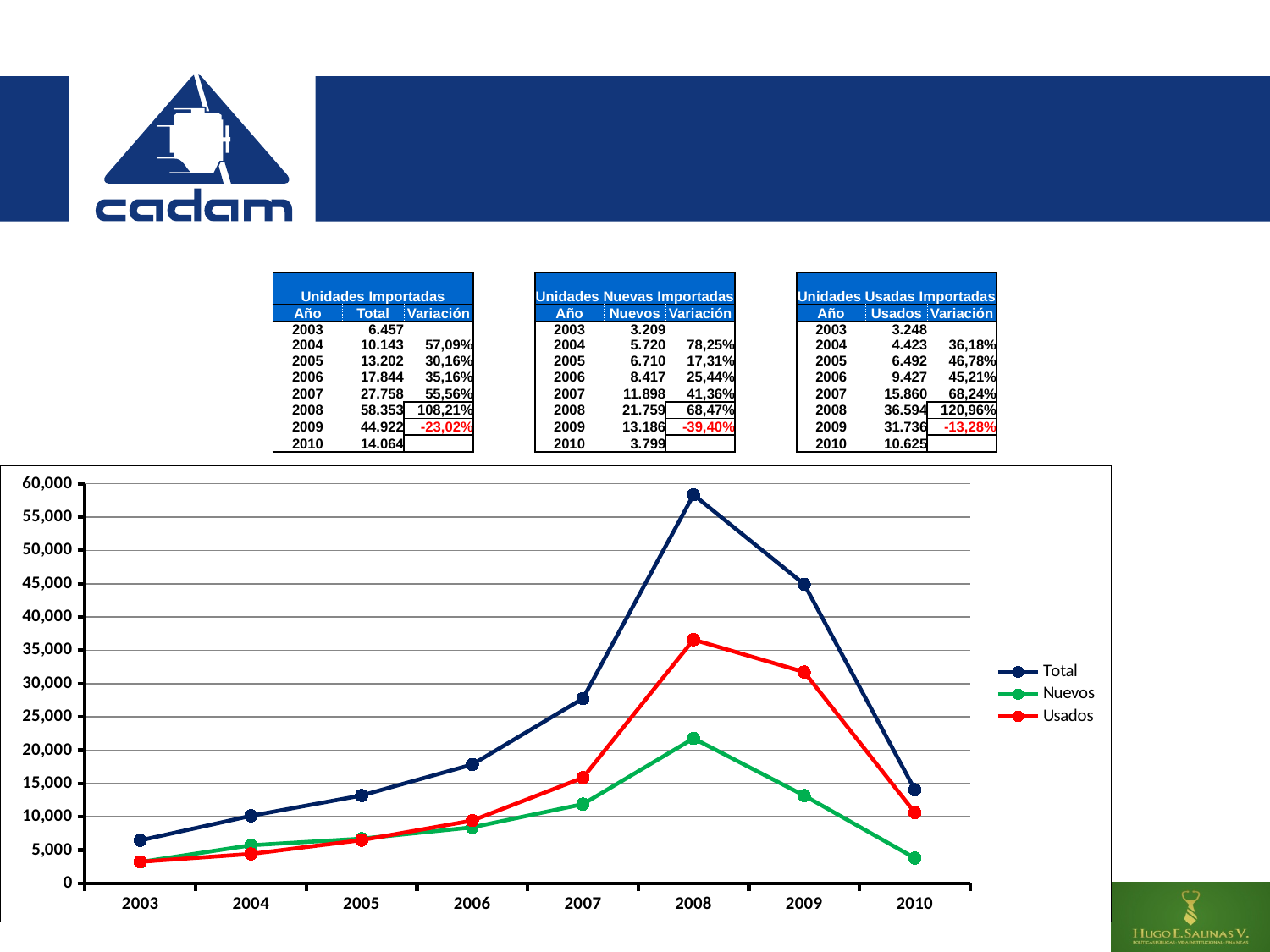
In which year does the Total series reach its highest value? 2008 What is the Variación shown for Nuevos in 2009? -39,40% According to the Unidades Importadas table, what is the Total for 2008? 58.353 What kind of chart is shown on the slide? line chart In 2009, which series has the larger value, Usados or Nuevos? Usados Is the Total value for 2008 on the chart greater or less than 55,000? greater How many series does the chart legend list? 3 Using the table values, what is the difference between Usados and Nuevos in 2008? 14.835 In which year is the Nuevos series at its lowest value? 2003 Is the Nuevos value for 2010 on the chart greater or less than 5,000? less According to the Unidades Usadas Importadas table, what is the Usados value for 2009? 31.736 How many years are plotted along the x axis of the chart? 8